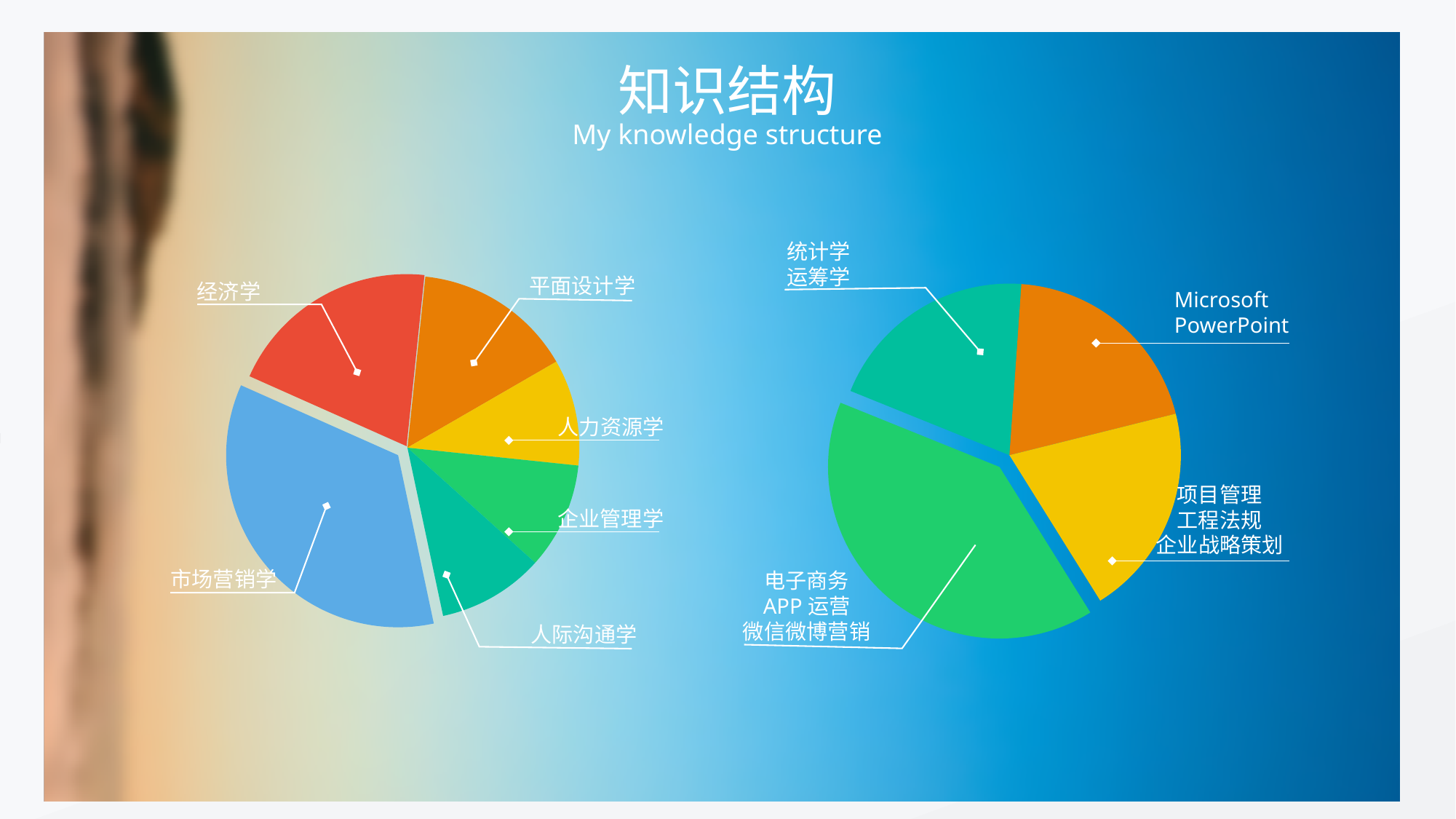
In the right pie chart, which slice is larger, Microsoft PowerPoint or 电子商务 / APP 运营 / 微信微博营销? 电子商务 / APP 运营 / 微信微博营销 In the left pie chart, which slice is larger, 市场营销学 or 平面设计学? 市场营销学 In the left pie chart, what colour is the 市场营销学 slice? Blue How many slices does the right pie chart have? 4 In the right pie chart, which slice is the largest? 电子商务 / APP 运营 / 微信微博营销 How many slices does the left pie chart have? 6 What kind of chart is the left chart on the slide? Pie chart In the left pie chart, which category has the largest slice? 市场营销学 What kind of chart is the right chart on the slide? Pie chart What is the English subtitle of the slide containing the two pie charts? My knowledge structure In the left pie chart, which slice is larger, 经济学 or 人力资源学? 经济学